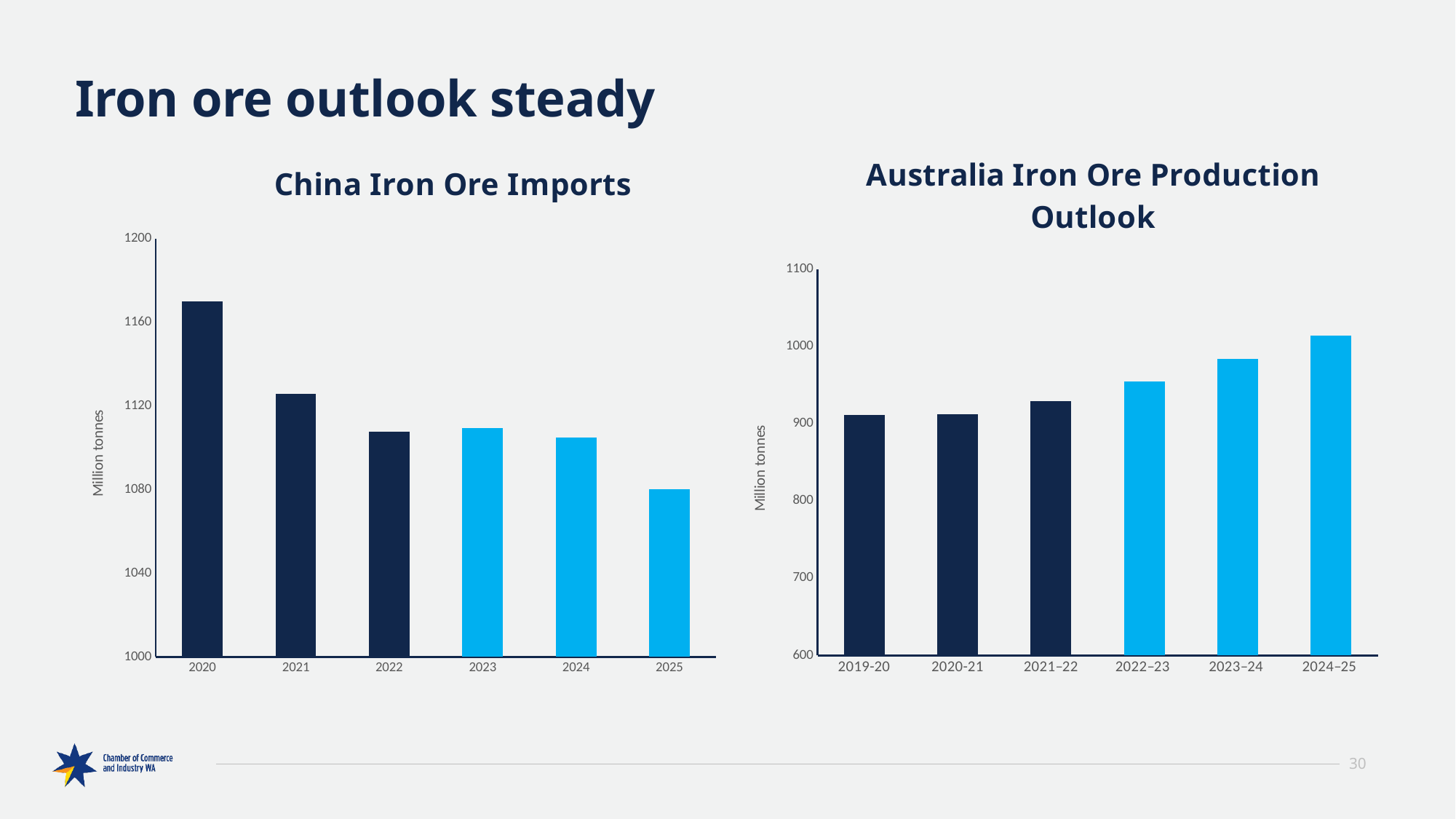
In the Australia Iron Ore Production Outlook chart, is the value for 2024-25 greater or less than 1000? greater What kind of chart is the Australia Iron Ore Production Outlook chart? bar chart In the Australia Iron Ore Production Outlook chart, is the value for 2023-24 greater or less than 1000? less In the Australia Iron Ore Production Outlook chart, which year has the highest value? 2024-25 In the China Iron Ore Imports chart, which year has the lowest value? 2025 In the China Iron Ore Imports chart, do the values generally rise or fall from 2020 to 2025? fall How many years are shown in the China Iron Ore Imports chart? 6 In the China Iron Ore Imports chart, is the value for 2020 greater or less than 1160? greater What is the y-axis label on the China Iron Ore Imports chart? Million tonnes In the Australia Iron Ore Production Outlook chart, do the values rise or fall from 2019-20 to 2024-25? rise In the China Iron Ore Imports chart, which year has the highest value? 2020